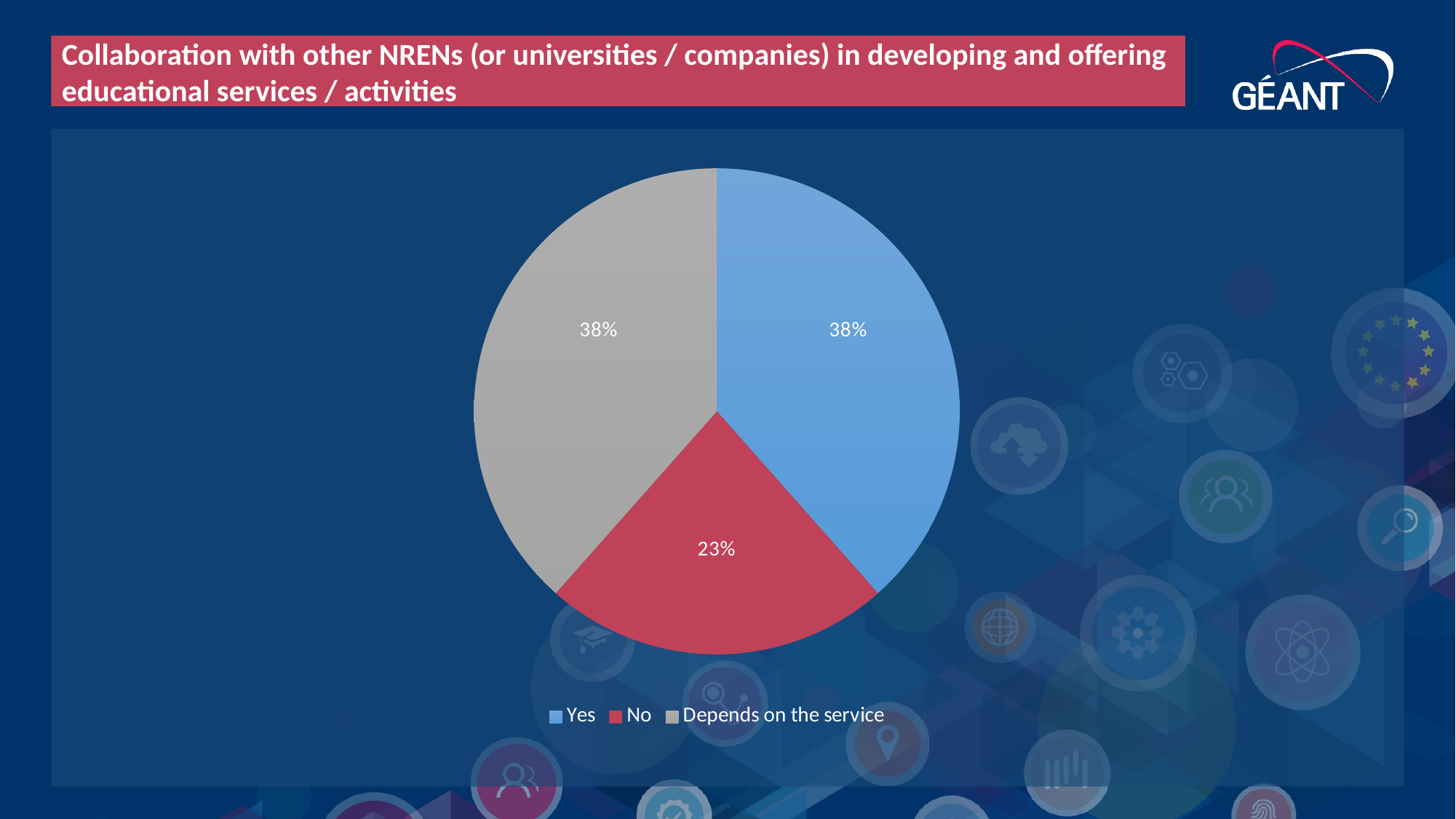
What share of the pie is labelled "Yes"? 38% What share of the pie is labelled "No"? 23% What is the difference between the "Yes" share and the "No" share? 15% How many entries does the legend list? 3 What colour is the "No" slice? red Which category has the smallest slice of the pie? No How many slices does the pie chart have? 3 What kind of chart is shown on the slide? pie chart Which is larger, the "Depends on the service" slice or the "No" slice? Depends on the service What share of the pie is labelled "Depends on the service"? 38% What colour is the "Depends on the service" slice? grey